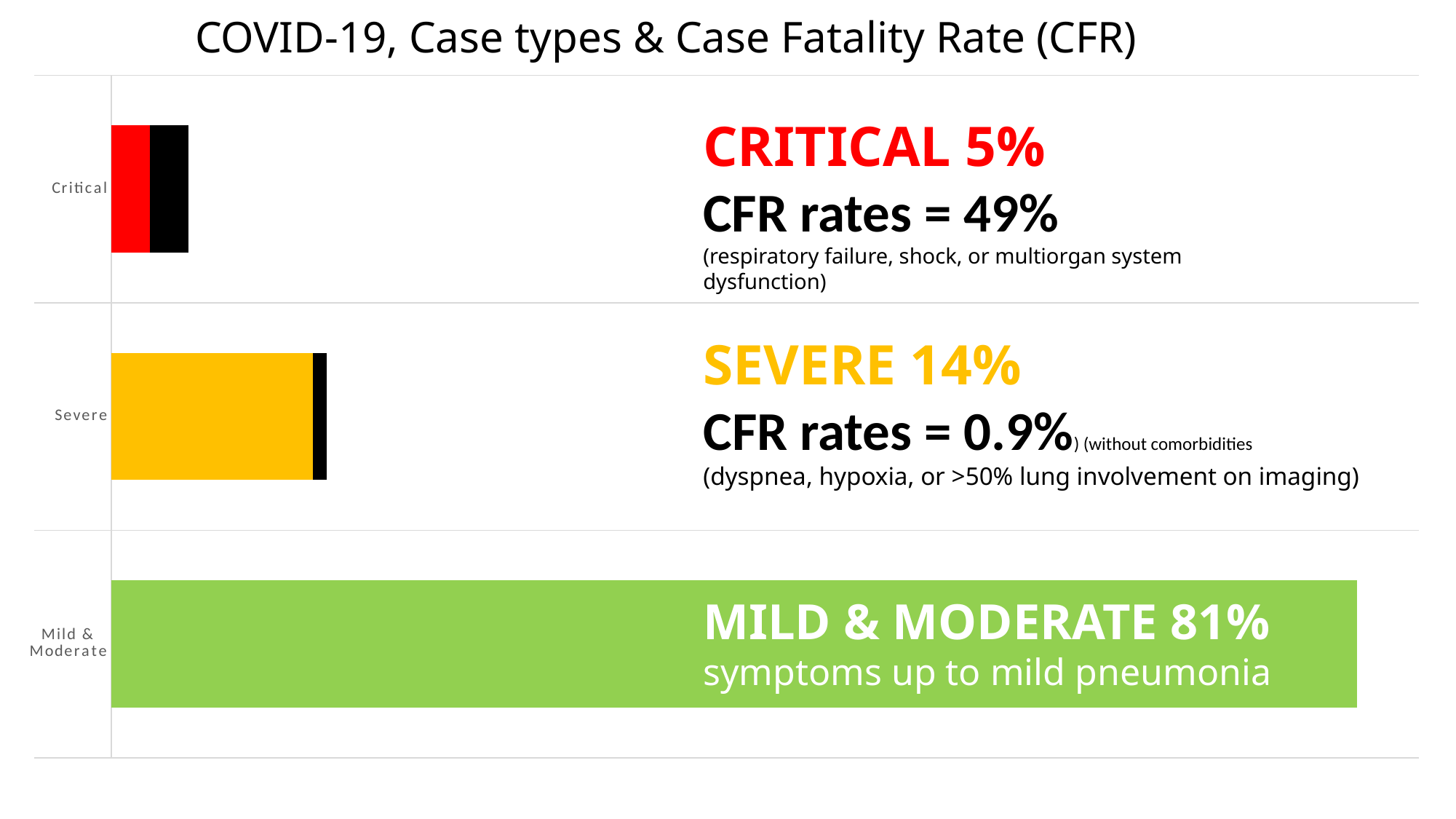
What CFR rate is given for Critical cases? 49% What CFR rate is given for Severe cases? 0.9% Which category has the longest bar? Mild & Moderate What share of cases is shown for the Mild & Moderate category? 81% What share of cases is shown for the Severe category? 14% What kind of chart is shown on the slide? bar chart What is the title of the chart? COVID-19, Case types & Case Fatality Rate (CFR) What share of cases is shown for the Critical category? 5% Which category has the shortest bar? Critical Which is larger, the share for Severe or the share for Critical? Severe What is the difference between the Mild & Moderate share and the Severe share? 67% How many case-type categories are plotted on the chart? 3